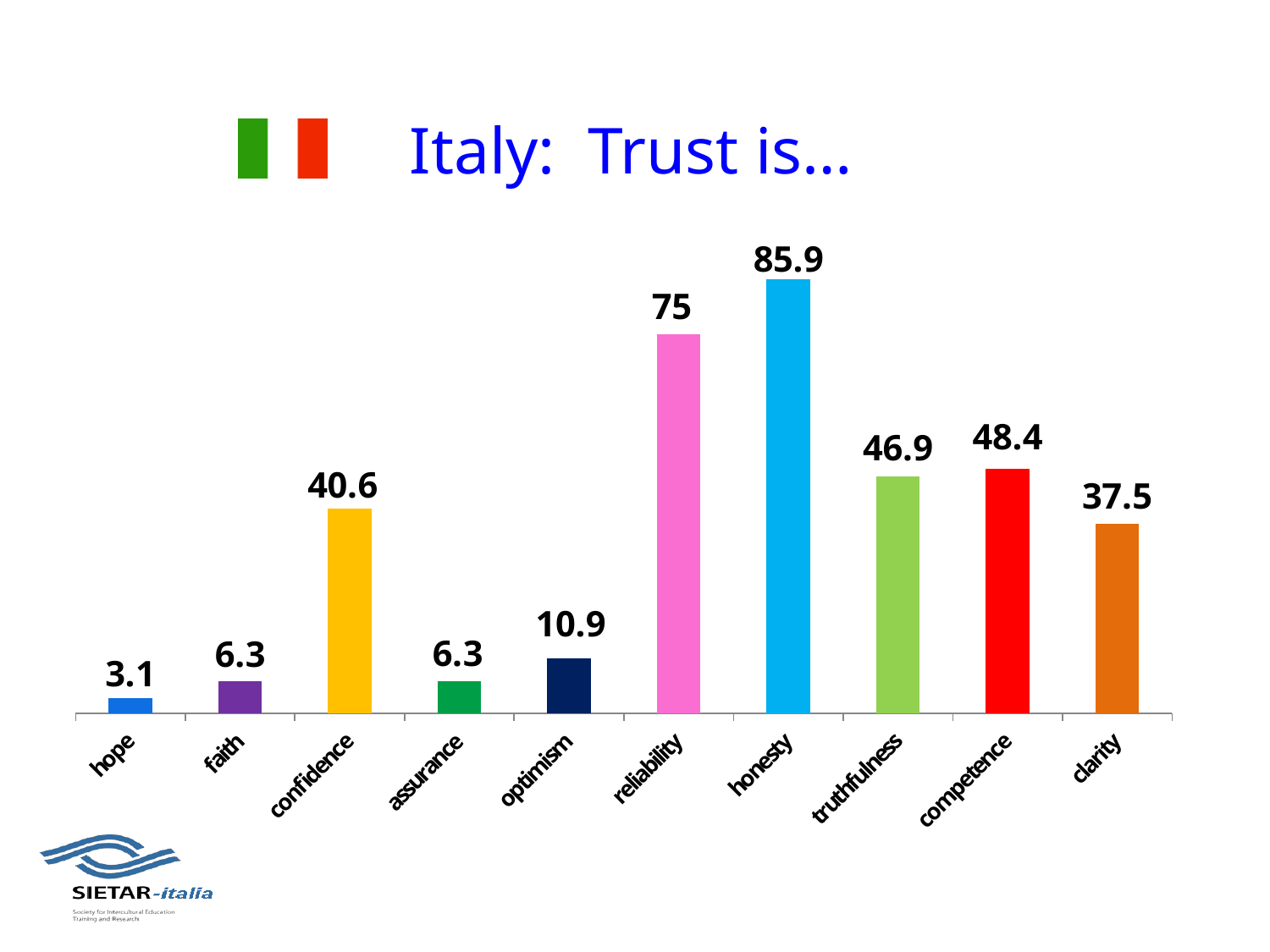
What is the value for confidence? 40.6 What kind of chart is shown on the slide? bar chart Which is larger, the value for competence or the value for clarity? competence What colour is the bar for reliability? pink What is the difference between the values for honesty and reliability? 10.9 How many categories are shown on the x axis? 10 Which category has the highest value? honesty What is the title of the slide? Italy: Trust is... What is the value for clarity? 37.5 What is the value for honesty? 85.9 What is the difference between the values for competence and truthfulness? 1.5 Which category has the lowest value? hope